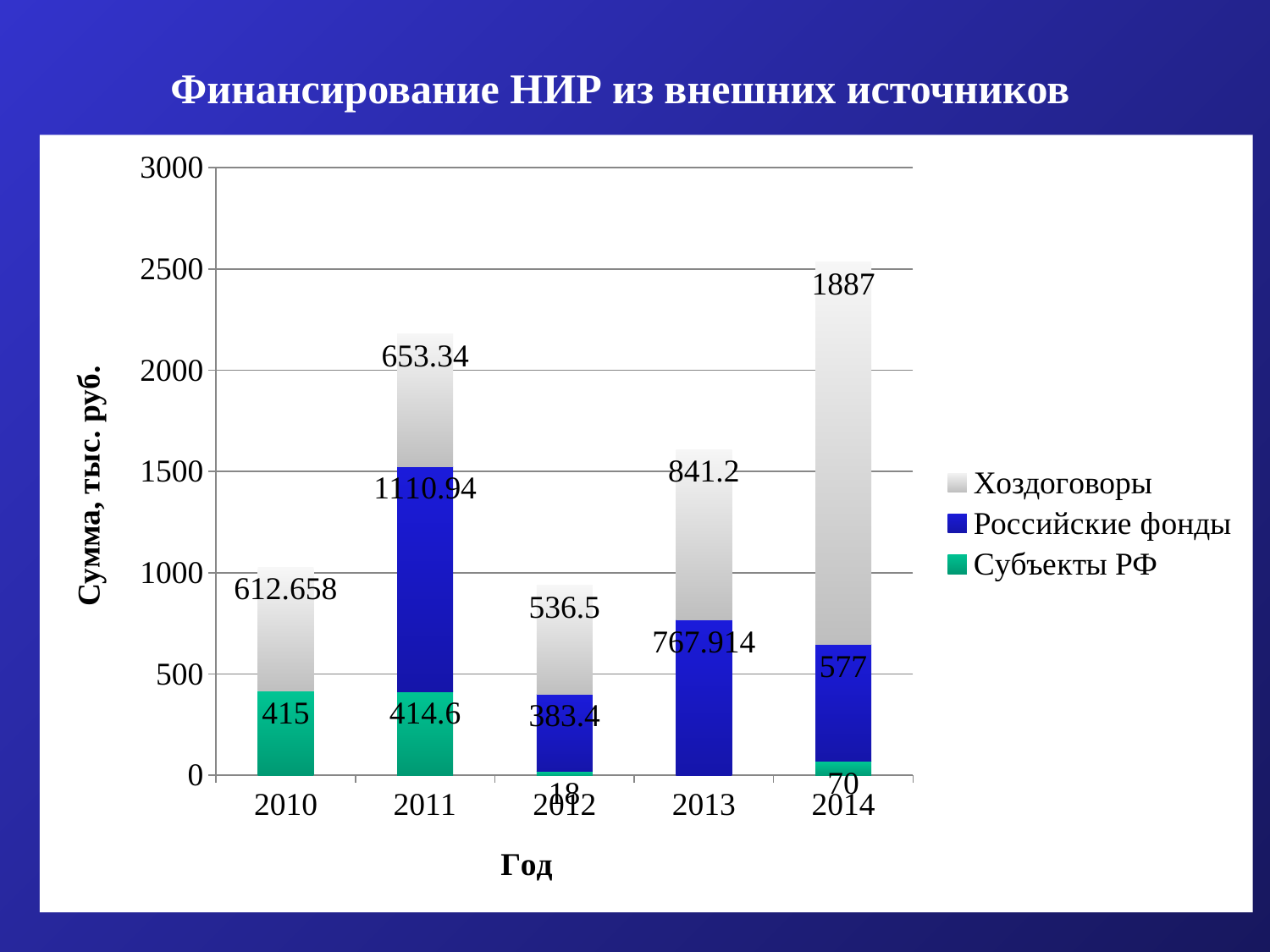
What is the value for Российские фонды in 2011? 1110.94 What is the difference between the Хоздоговоры values for 2014 and 2011? 1233.66 What is the value for Хоздоговоры in 2010? 612.658 In which year is the Хоздоговоры value highest? 2014 How many series does the legend list? 3 What is the value for Хоздоговоры in 2014? 1887 In 2013, which is larger: Хоздоговоры or Российские фонды? Хоздоговоры What is the total of the stacked bar for 2014? 2534 What kind of chart is shown on the slide? Stacked bar chart In which year is the Хоздоговоры value lowest? 2012 What is the value for Субъекты РФ in 2012? 18 What is the total of the stacked bar for 2012? 937.9